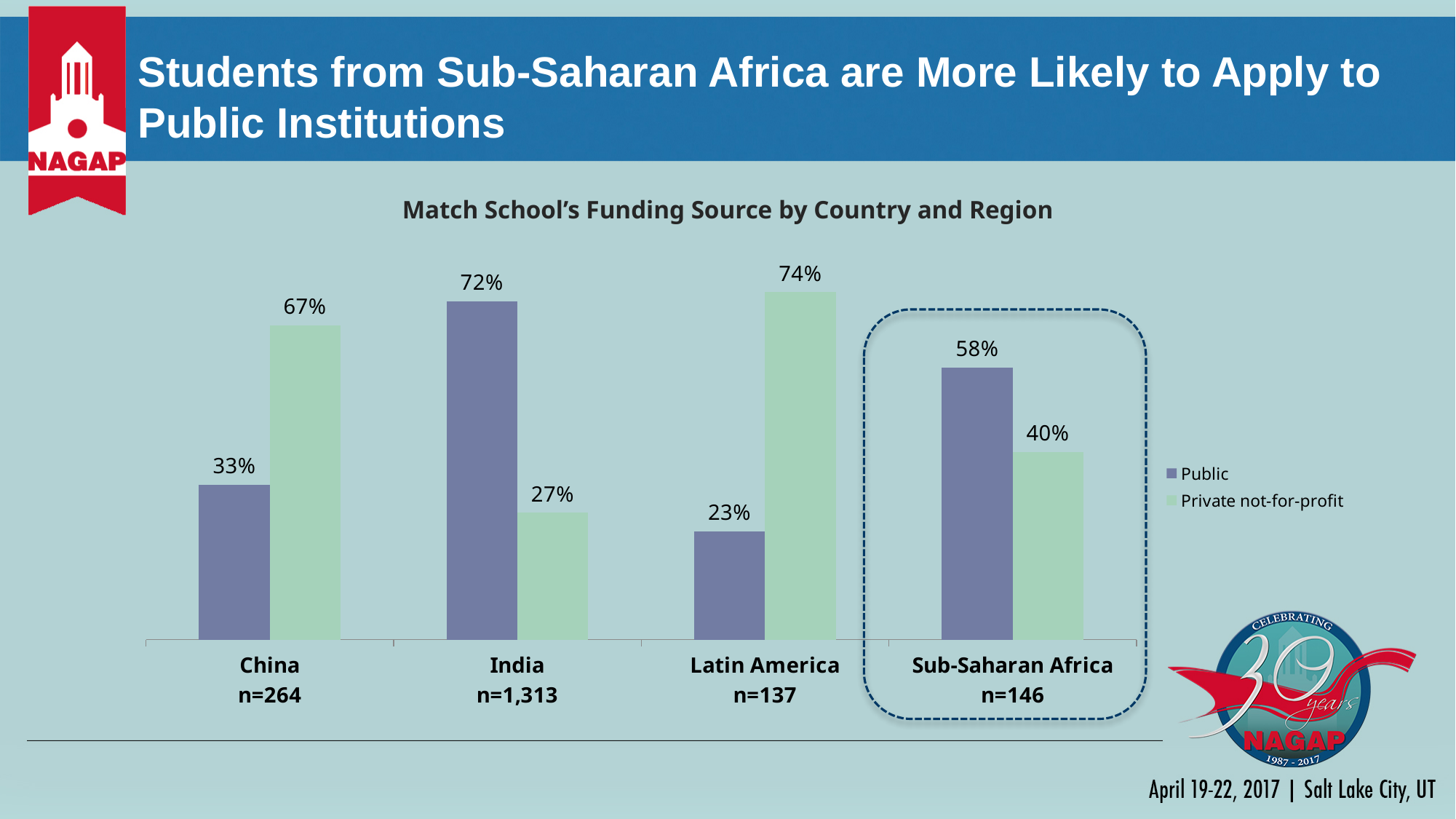
How many countries or regions are shown on the x axis? 4 What is the sample size (n) shown for India? n=1,313 Which country or region has the lowest Public value? Latin America What is the Public value for Sub-Saharan Africa? 58% How many series does the legend list? 2 Which is larger for India: the Public value or the Private not-for-profit value? Public What is the Private not-for-profit value for India? 27% What is the Public value for China? 33% Which country or region has the highest Private not-for-profit value? Latin America What kind of chart is shown on the slide? Bar chart What is the title of the chart? Match School's Funding Source by Country and Region What is the difference between the Public and Private not-for-profit values for Sub-Saharan Africa? 18%